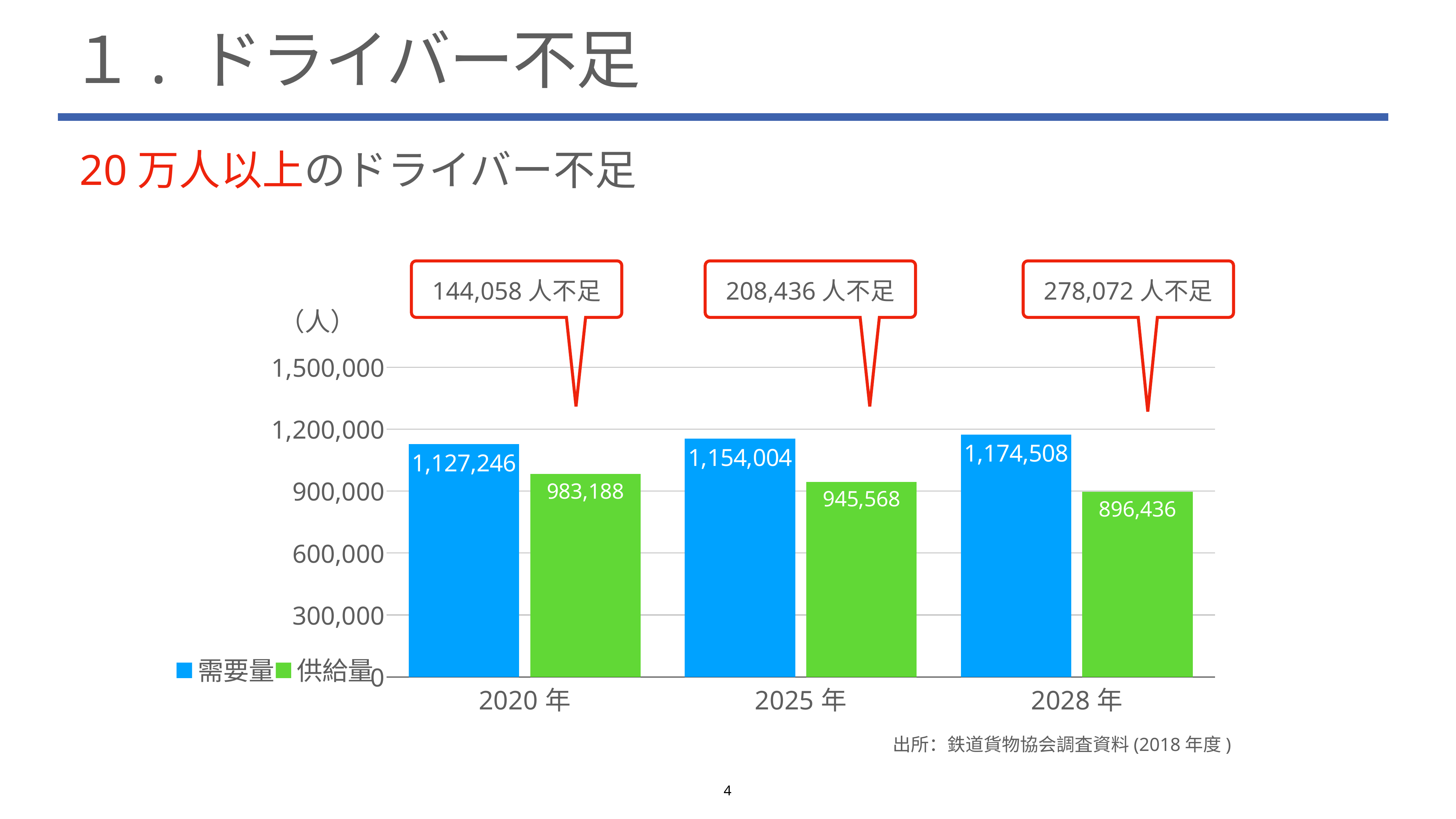
Is the 供給量 value for 2028年 greater or less than 900,000? less What is the 供給量 value for 2025年? 945,568 What is the 需要量 value for 2020年? 1,127,246 What is the difference between 需要量 and 供給量 in 2028年? 278,072 Which year has the lowest 供給量? 2028年 What is the difference between 需要量 and 供給量 in 2025年? 208,436 Which year has the highest 需要量? 2028年 How many series does the legend list? 2 How many years are shown on the x axis? 3 Which is larger in 2020年, 需要量 or 供給量? 需要量 Does 供給量 rise or fall from 2020年 to 2028年? fall What is the 供給量 value for 2028年? 896,436